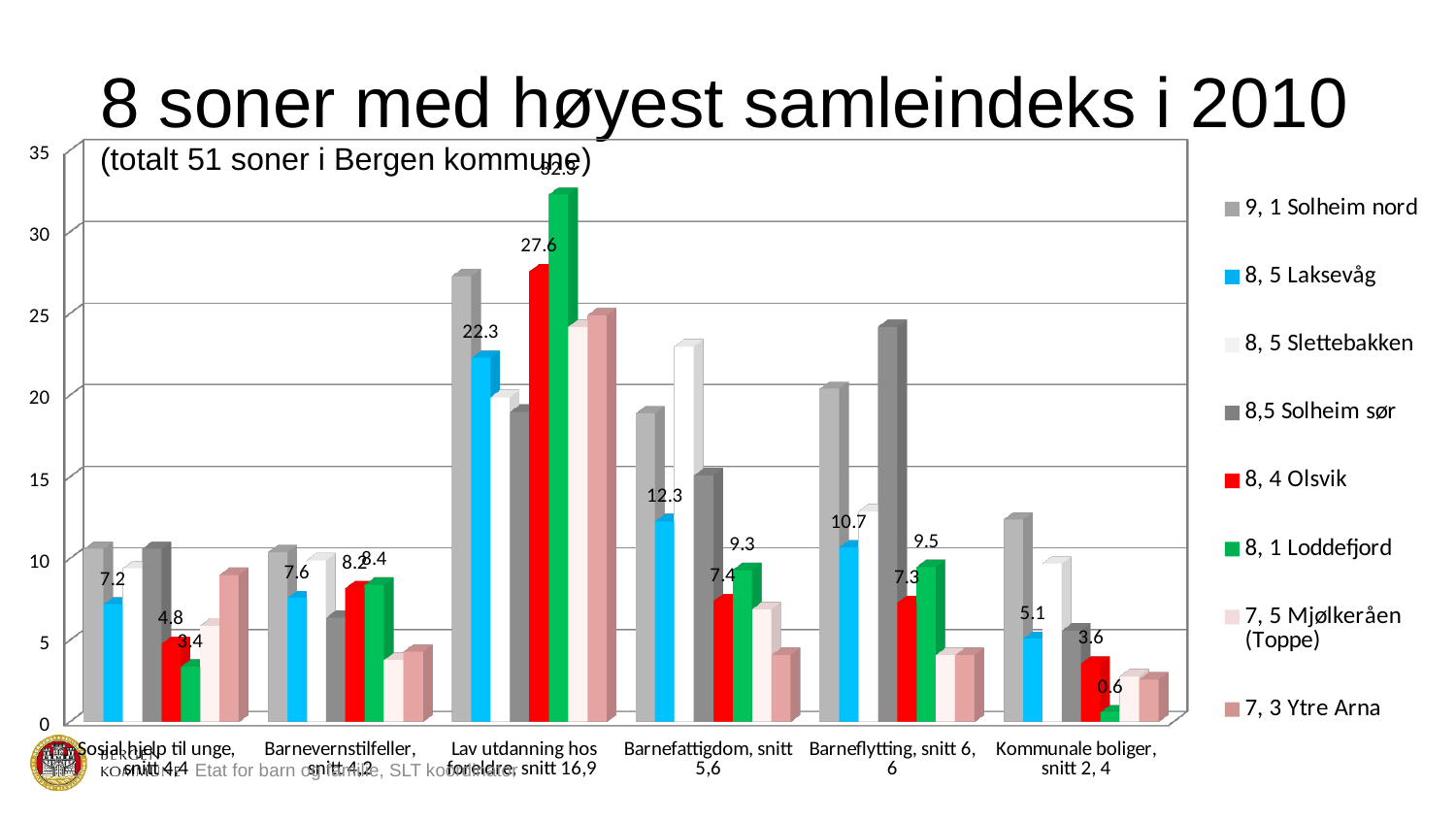
What is the value for 8, 1 Loddefjord in the category 'Kommunale boliger, snitt 2, 4'? 0.6 In the category 'Lav utdanning hos foreldre, snitt 16,9', how much higher is the value for 8, 4 Olsvik than for 8, 5 Laksevåg? 5.3 Is the value for 9, 1 Solheim nord in the category 'Lav utdanning hos foreldre, snitt 16,9' greater or less than 25? greater What is the value for 8, 5 Laksevåg in the category 'Lav utdanning hos foreldre, snitt 16,9'? 22.3 Is the value for 8, 5 Slettebakken in the category 'Barnefattigdom, snitt 5,6' greater or less than 20? greater How many categories are shown on the x axis of the chart? 6 In which category does 8, 1 Loddefjord have its lowest value? Kommunale boliger, snitt 2, 4 In the category 'Barnefattigdom, snitt 5,6', which is larger: the value for 8, 5 Laksevåg or for 8, 1 Loddefjord? 8, 5 Laksevåg What kind of chart is shown on the slide? bar chart In the category 'Barneflytting, snitt 6, 6', what is the difference between the values for 8, 5 Laksevåg and 8, 4 Olsvik? 3.4 How many series does the legend list? 8 What is the value for 8, 4 Olsvik in the category 'Sosialhjelp til unge, snitt 4,4'? 4.8